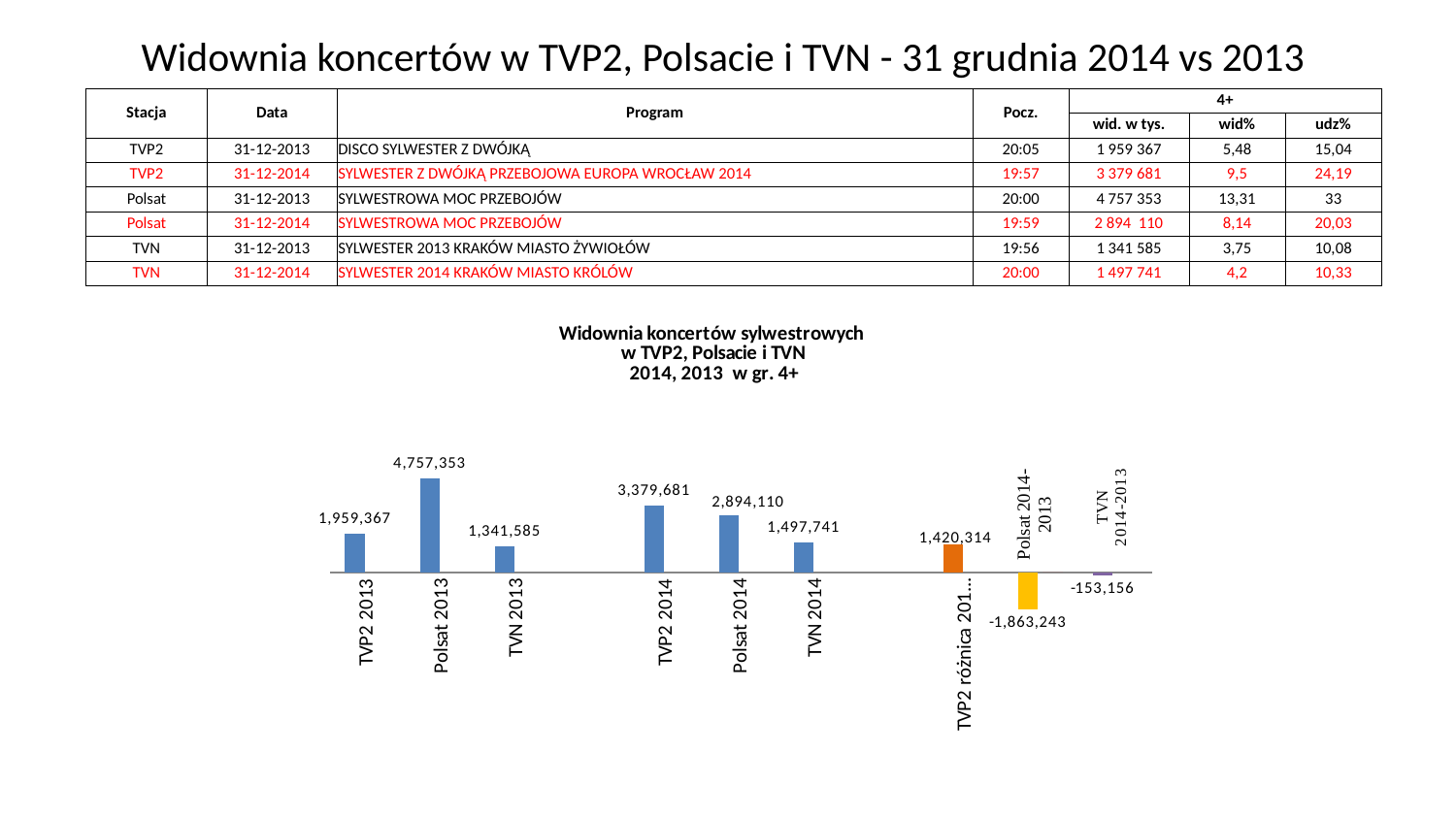
Which is larger, the bar for TVP2 2013 or the bar for TVN 2013? TVP2 2013 What is the value of the bar for TVN 2014-2013? -153,156 What is the value of the bar for Polsat 2013? 4,757,353 What type of chart is shown on the slide? bar chart What is the value of the bar for TVN 2014? 1,497,741 How many bars are plotted in the chart? 9 Which bar has the lowest value in the chart? Polsat 2014-2013 Which bar has the highest value in the chart? Polsat 2013 What is the value of the bar for TVP2 2014? 3,379,681 What is the value of the bar for Polsat 2014-2013? -1,863,243 What is the title of the chart? Widownia koncertów sylwestrowych w TVP2, Polsacie i TVN 2014, 2013 w gr. 4+ What is the difference between the bars for Polsat 2013 and Polsat 2014? 1,863,243